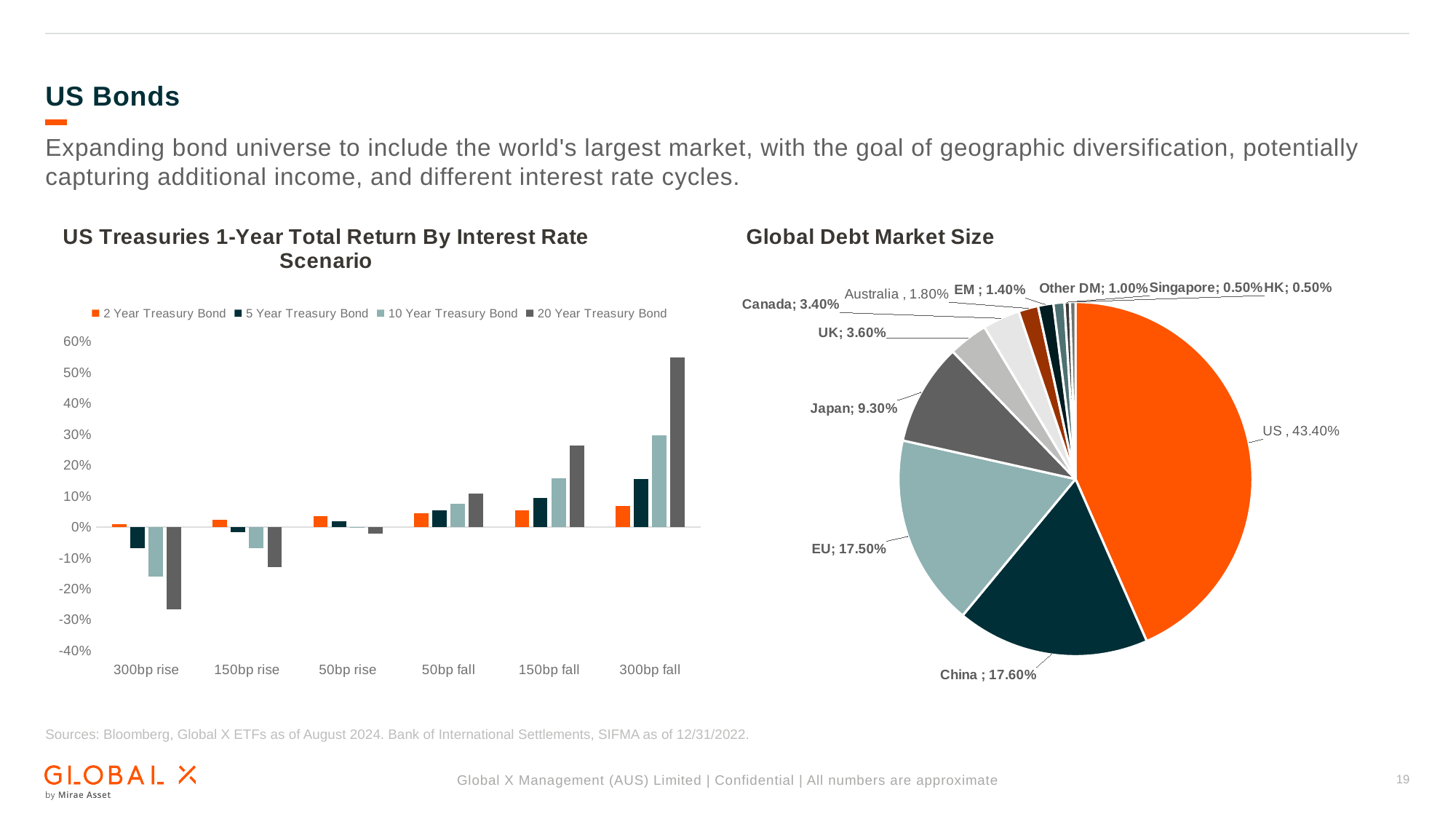
In the 'US Treasuries 1-Year Total Return By Interest Rate Scenario' chart, is the value for the 20 Year Treasury Bond under the 300bp rise scenario greater or less than -20%? less In the 'Global Debt Market Size' chart, what is the difference between the US share and the China share? 25.80% How many interest rate scenarios are shown on the x axis of the 'US Treasuries 1-Year Total Return By Interest Rate Scenario' chart? 6 In the 'US Treasuries 1-Year Total Return By Interest Rate Scenario' chart, do the 20 Year Treasury Bond values rise or fall moving from 300bp rise to 300bp fall along the x axis? rise How many slices are shown in the 'Global Debt Market Size' pie chart? 11 In the 'US Treasuries 1-Year Total Return By Interest Rate Scenario' chart, which series has the highest return under the 300bp fall scenario? 20 Year Treasury Bond In the 'US Treasuries 1-Year Total Return By Interest Rate Scenario' chart, is the value for the 20 Year Treasury Bond under the 300bp fall scenario greater or less than 50%? greater In the 'Global Debt Market Size' chart, what share does the US have? 43.40% How many series does the legend of the 'US Treasuries 1-Year Total Return By Interest Rate Scenario' chart list? 4 In the 'Global Debt Market Size' chart, what is the value for Japan? 9.30% What type of chart is the 'US Treasuries 1-Year Total Return By Interest Rate Scenario' chart? bar chart What type of chart is the 'Global Debt Market Size' chart? pie chart